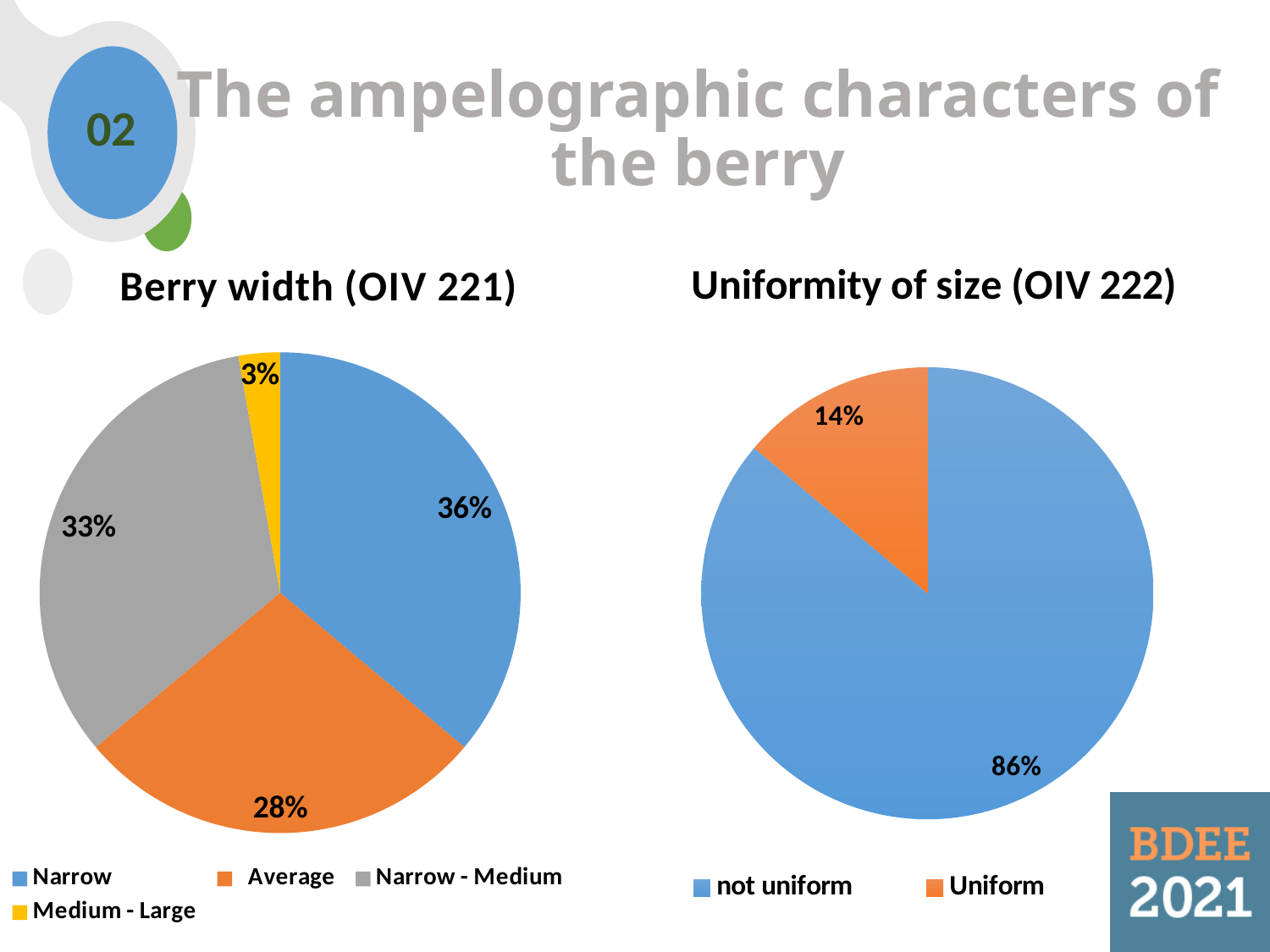
In the Berry width (OIV 221) chart, how many categories does the legend list? 4 In the Berry width (OIV 221) chart, which category has the smallest slice? Medium - Large In the Berry width (OIV 221) chart, what share of the pie is Narrow? 36% In the Uniformity of size (OIV 222) chart, what share of the pie is not uniform? 86% In the Uniformity of size (OIV 222) chart, what is the difference between not uniform and Uniform? 72% In the Berry width (OIV 221) chart, which category has the largest slice? Narrow What type of chart is the Uniformity of size (OIV 222) chart? Pie chart In the Berry width (OIV 221) chart, what is the difference between Narrow and Average? 8% In the Uniformity of size (OIV 222) chart, what is the value for Uniform? 14% In the Berry width (OIV 221) chart, what is the value for Narrow - Medium? 33% In the Berry width (OIV 221) chart, what is the value for Average? 28% In the Uniformity of size (OIV 222) chart, which is larger, not uniform or Uniform? not uniform